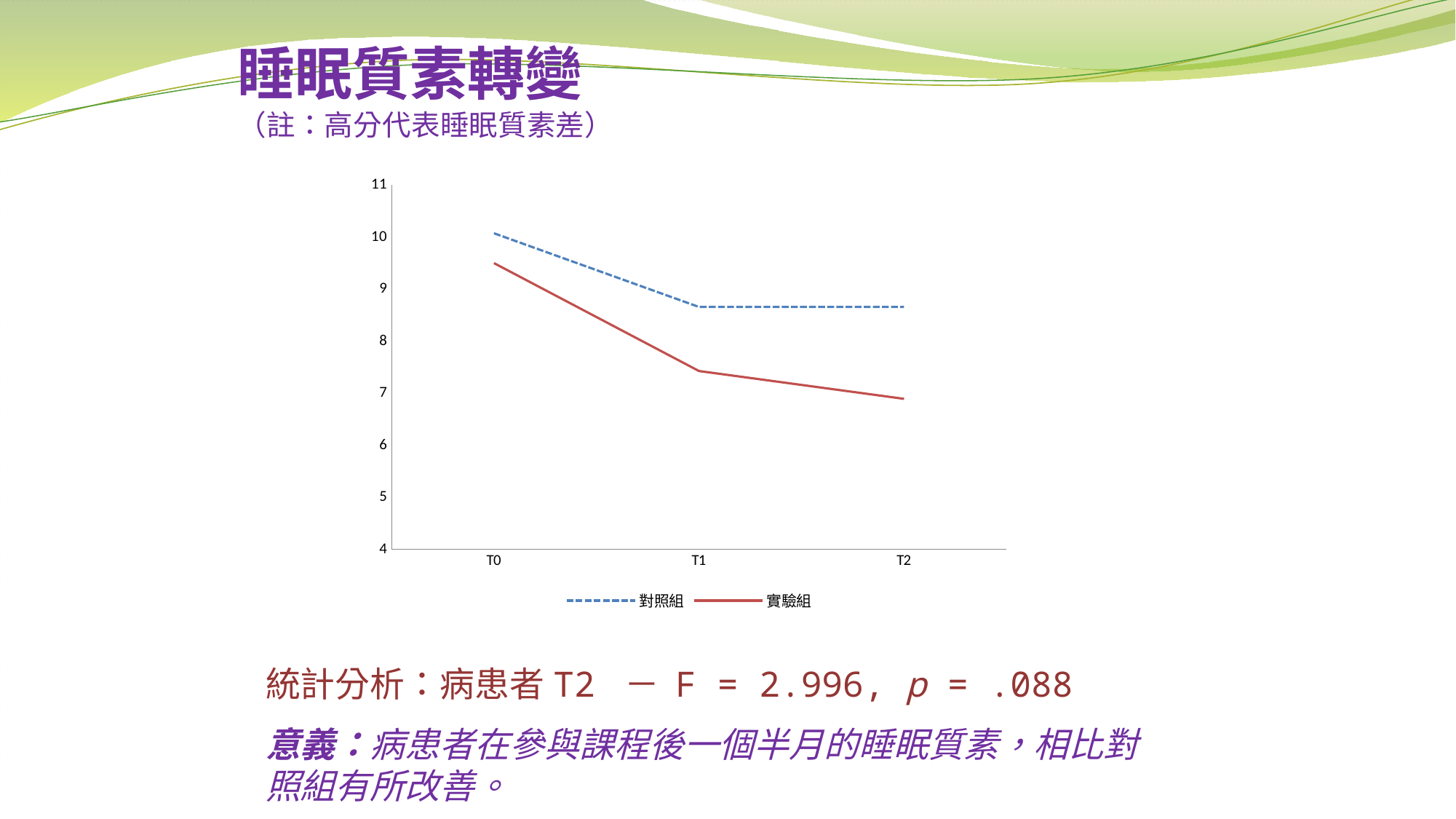
Which series is shown with a dashed line? 對照組 Which series has the higher value at T0, 對照組 or 實驗組? 對照組 Which series has the higher value at T2, 對照組 or 實驗組? 對照組 How many time points are shown on the x axis? 3 At which time point does 實驗組 have its lowest value? T2 What kind of chart is shown on the slide? line chart Is the value for 實驗組 at T0 greater or less than 9? greater Is the value for 實驗組 at T2 greater or less than 7? less How many series does the legend list? 2 Is the value for 對照組 at T2 greater or less than 9? less Does the value for 實驗組 rise or fall from T0 to T2? fall